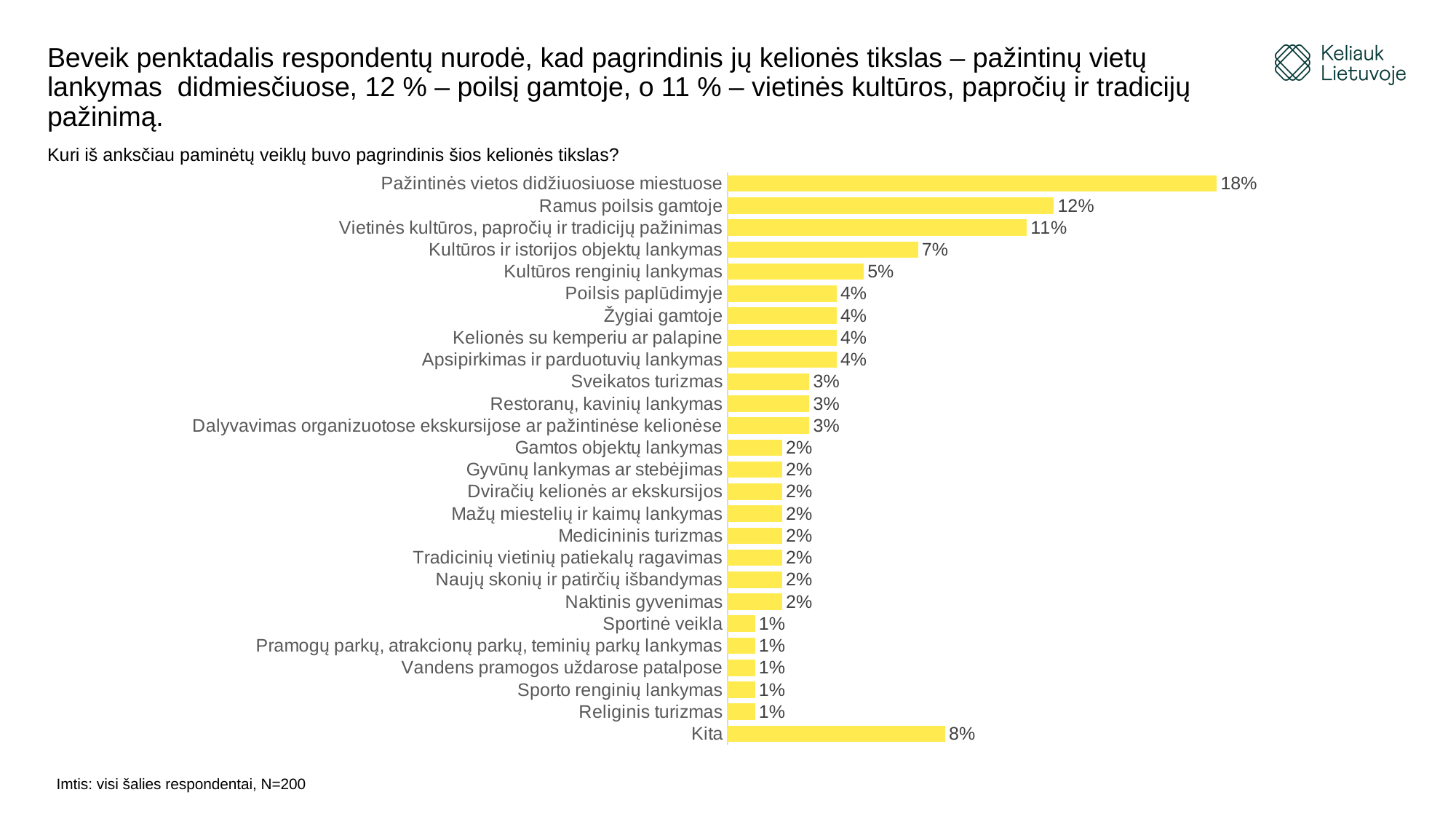
What is the value for Ramus poilsis gamtoje? 12% What is the value for Kita? 8% What is the value for Pažintinės vietos didžiuosiuose miestuose? 18% What is the value for Kultūros ir istorijos objektų lankymas? 7% Which is larger, Vietinės kultūros, papročių ir tradicijų pažinimas or Kita? Vietinės kultūros, papročių ir tradicijų pažinimas What is the value for Sveikatos turizmas? 3% What kind of chart is shown on the slide? bar chart What is the difference between Pažintinės vietos didžiuosiuose miestuose and Ramus poilsis gamtoje? 6% What is the difference between Kita and Kultūros renginių lankymas? 3% What question is the chart based on, as stated above it? Kuri iš anksčiau paminėtų veiklų buvo pagrindinis šios kelionės tikslas? Which category has the highest value? Pažintinės vietos didžiuosiuose miestuose How many categories are shown in the chart? 26